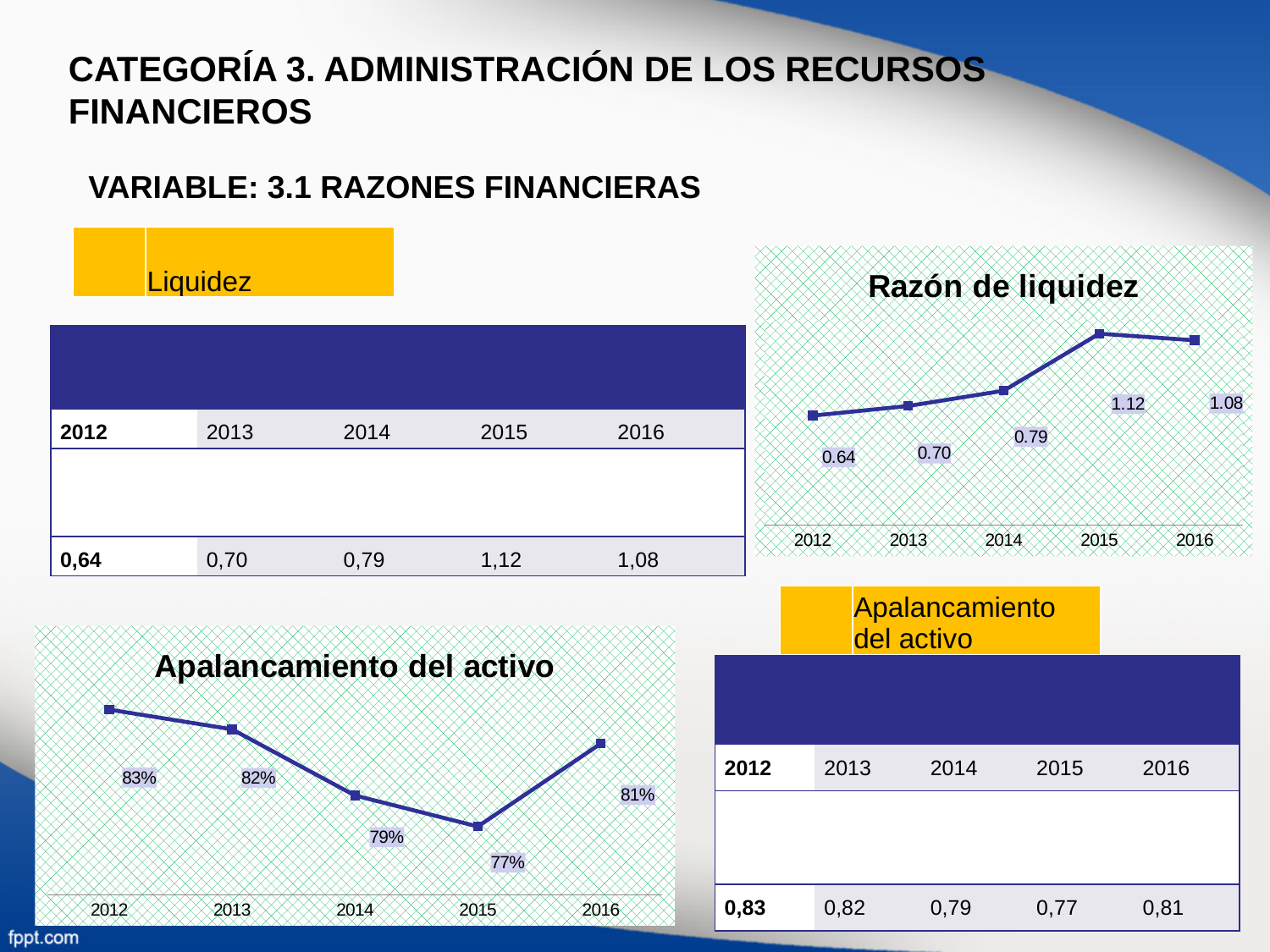
In the 'Apalancamiento del activo' chart, which year has the highest value? 2012 What kind of chart is 'Razón de liquidez'? Line chart In the 'Apalancamiento del activo' chart, which year has the lowest value? 2015 In the 'Razón de liquidez' chart, what is the difference between the values for 2015 and 2012? 0.48 In the 'Apalancamiento del activo' chart, what is the difference between the values for 2012 and 2015? 6% In the 'Razón de liquidez' chart, how many data points are plotted? 5 In the 'Apalancamiento del activo' chart, which is larger, the value for 2013 or the value for 2016? 2013 In the 'Razón de liquidez' chart, which year has the lowest value? 2012 In the 'Razón de liquidez' chart, which year has the highest value? 2015 In the 'Apalancamiento del activo' chart, do the values rise or fall from 2012 to 2015? Fall In the 'Razón de liquidez' chart, what is the value for 2014? 0.79 In the 'Apalancamiento del activo' chart, what is the value for 2015? 77%